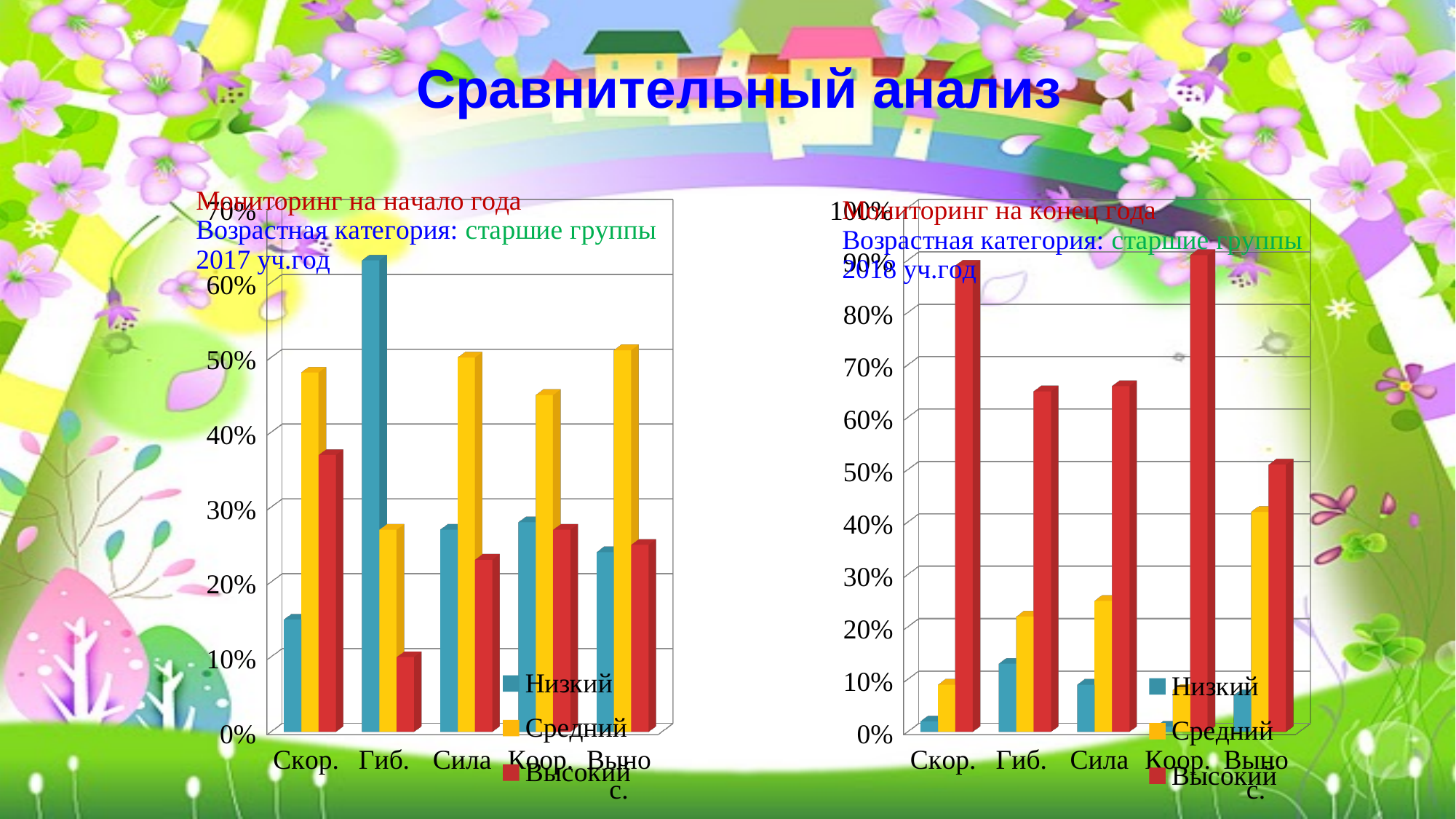
On the right chart (Мониторинг на конец года), which category has the lowest value for the Высокий series? Вынос. On the right chart (Мониторинг на конец года), is the Низкий value for Гиб. greater or less than 20%? less How many categories are shown on the x axis of the left chart (Мониторинг на начало года)? 5 On the right chart (Мониторинг на конец года), is the Средний value for Вынос. greater or less than 30%? greater On the right chart (Мониторинг на конец года), which is larger for Сила: the Средний value or the Высокий value? Высокий On the left chart (Мониторинг на начало года), is the Низкий value for Гиб. greater or less than 60%? greater On the left chart (Мониторинг на начало года), which category has the highest value for the Низкий series? Гиб. On the left chart (Мониторинг на начало года), which is larger for Гиб.: the Низкий value or the Высокий value? Низкий How many series does the legend of the right chart (Мониторинг на конец года) list? 3 What kind of chart is the left chart (Мониторинг на начало года)? bar chart